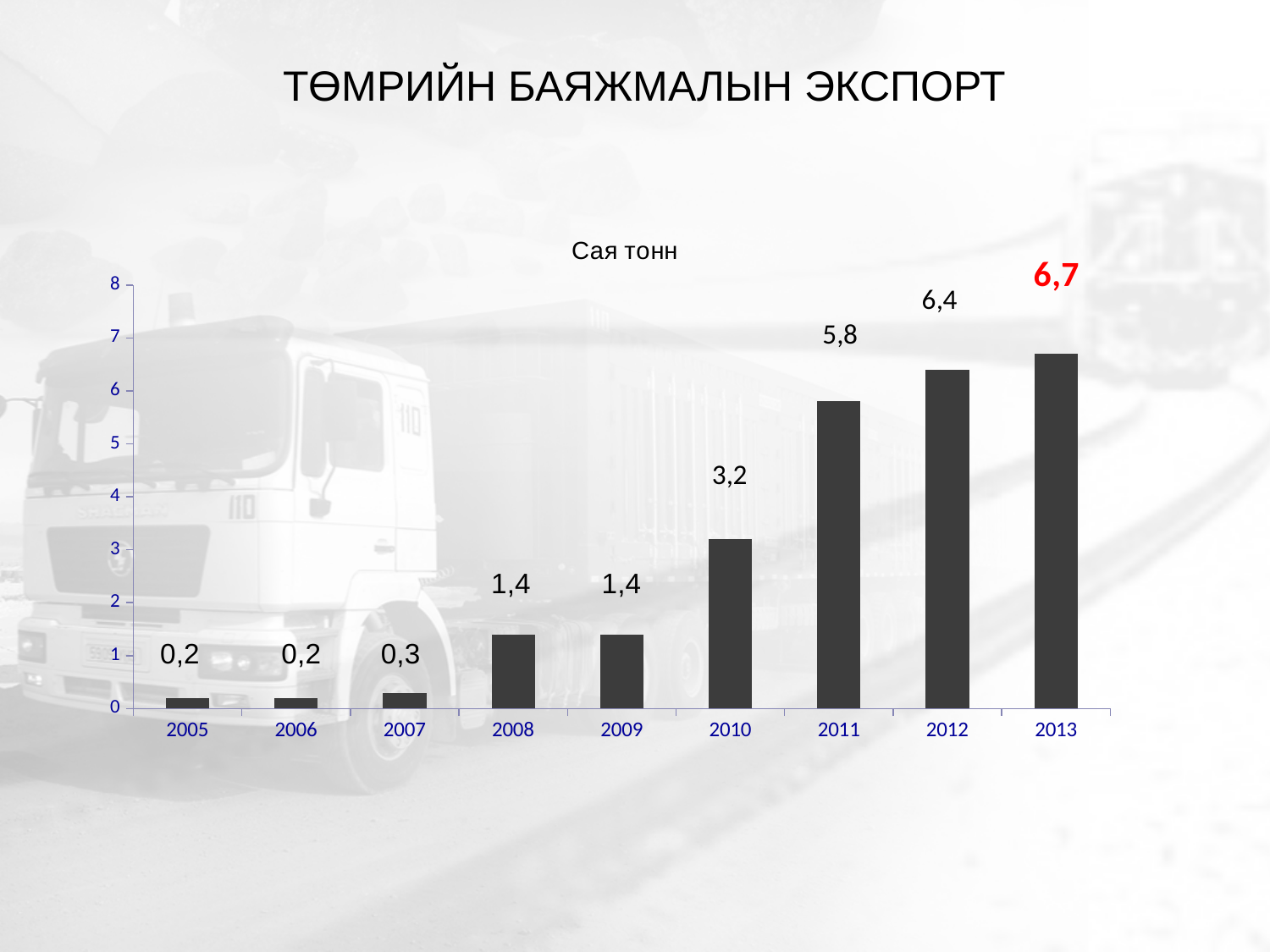
What is the value for 2013? 6,7 How many years are shown on the x axis? 9 What is the difference between the values for 2012 and 2011? 0,6 What is the value for 2007? 0,3 Do the values generally rise or fall from 2005 to 2013? rise What is the title of the chart? Сая тонн Which data label is shown in red? 6,7 Which year has the highest value? 2013 Which is larger, the value for 2010 or the value for 2009? 2010 Is the value for 2011 greater or less than 5? greater What is the value for 2010? 3,2 What kind of chart is shown on the slide? bar chart